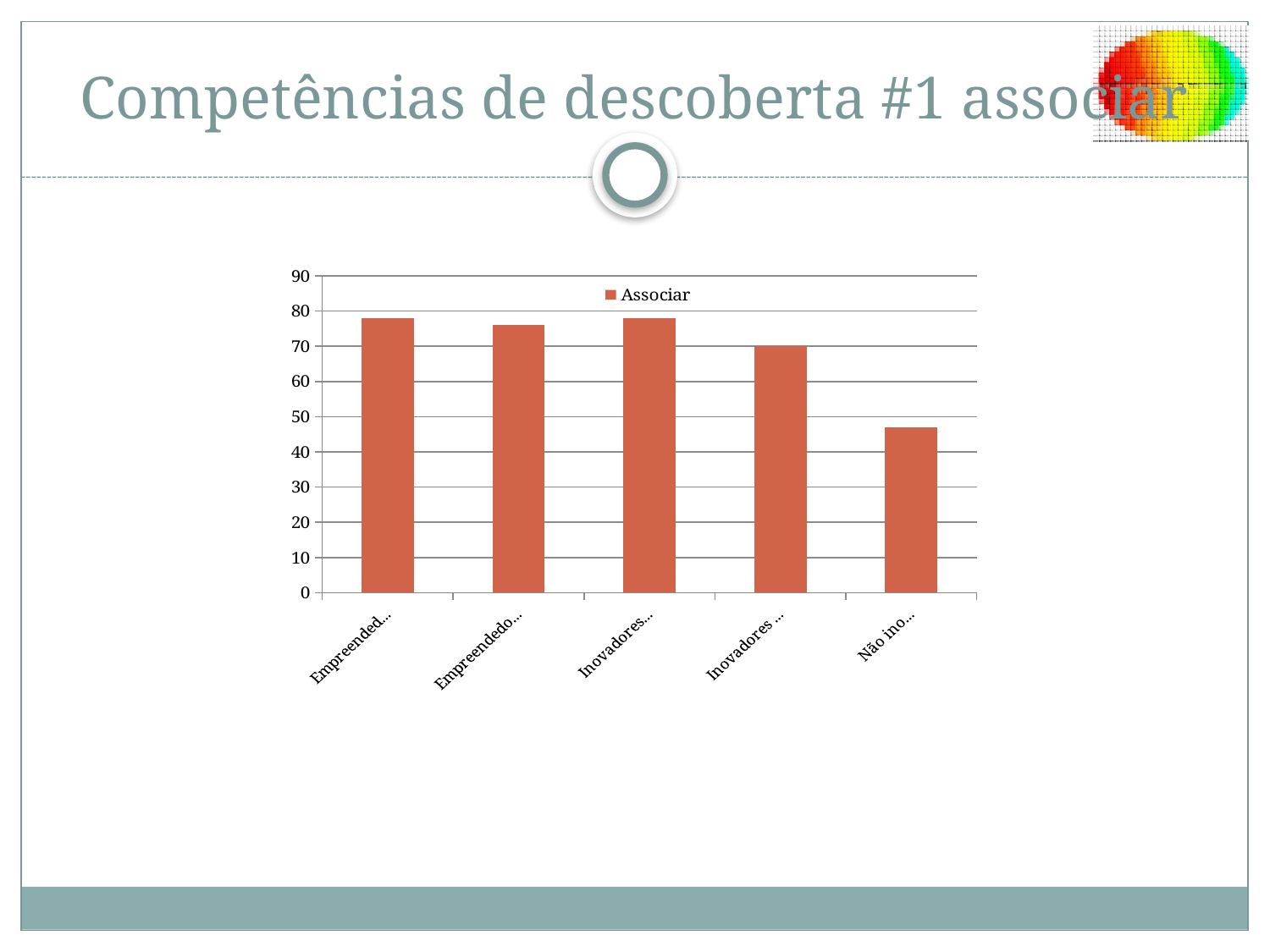
Which is larger, the value of the fourth bar or the value of the last bar? the fourth bar Is the value of the second bar greater or less than 70? greater Is the value of the last (rightmost) bar greater or less than 50? less Which bar is the lowest in the chart? the last (rightmost) bar, Não ino... What is the highest value shown on the vertical axis? 90 What is the name of the series shown in the legend? Associar Is the value of the first (leftmost) bar greater or less than 70? greater How many series does the legend list? 1 What kind of chart is shown on the slide? bar chart How many bars does the chart have? 5 Which is larger, the value of the first bar or the value of the last bar? the first bar